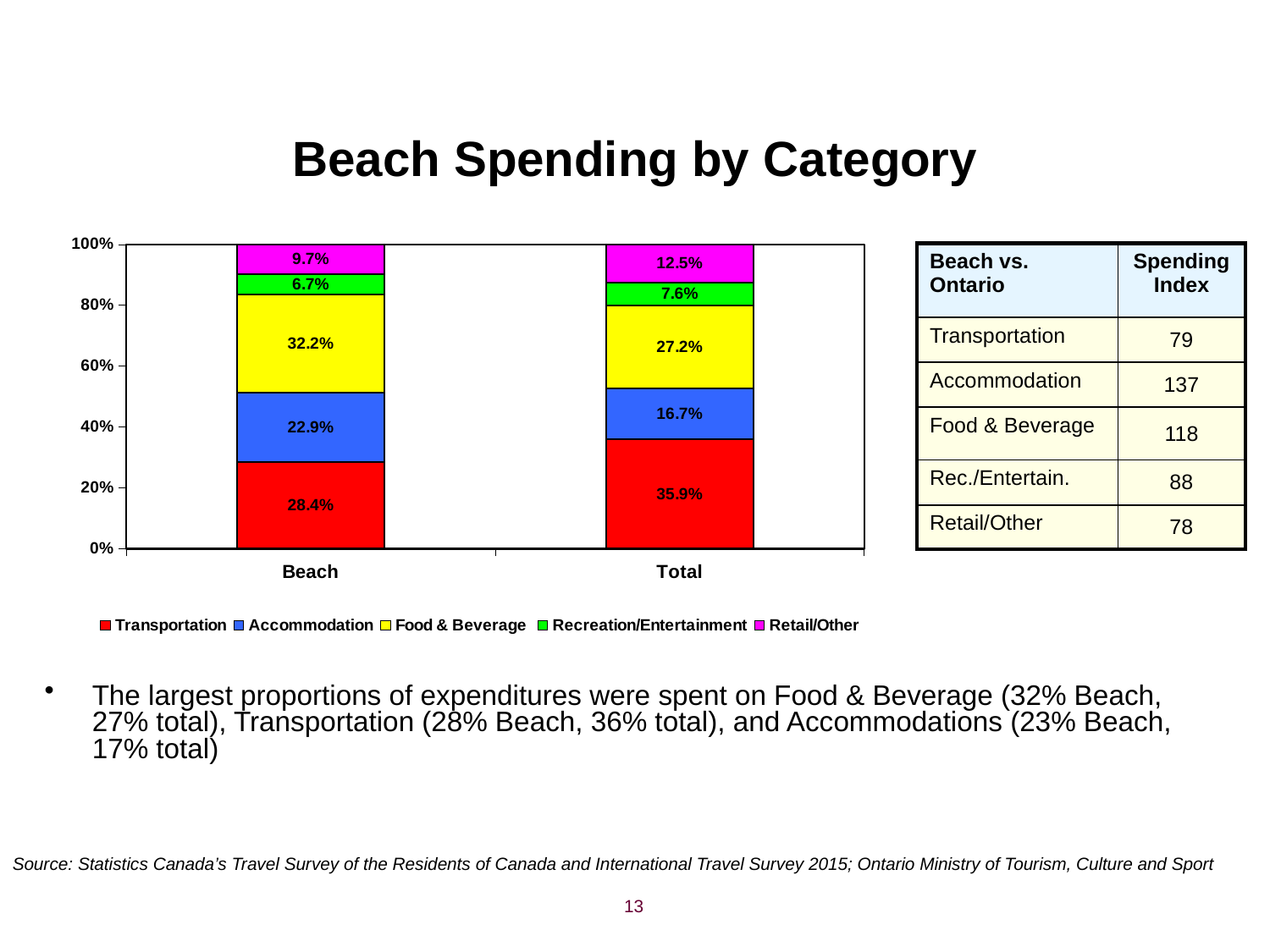
Which spending category has the smallest share in the Total bar? Recreation/Entertainment What is the Transportation share for Total? 35.9% What is the Food & Beverage share for Beach? 32.2% What is the Recreation/Entertainment share for Beach? 6.7% How many series does the legend list? 5 What is the Accommodation share for Beach? 22.9% How many bars are shown on the x axis? 2 What kind of chart is shown on the slide? Stacked bar chart Is the Accommodation share larger for Beach or for Total? Beach What is the Retail/Other share for Total? 12.5% What is the difference between the Transportation share for Total and for Beach? 7.5 percentage points Which spending category has the largest share in the Beach bar? Food & Beverage